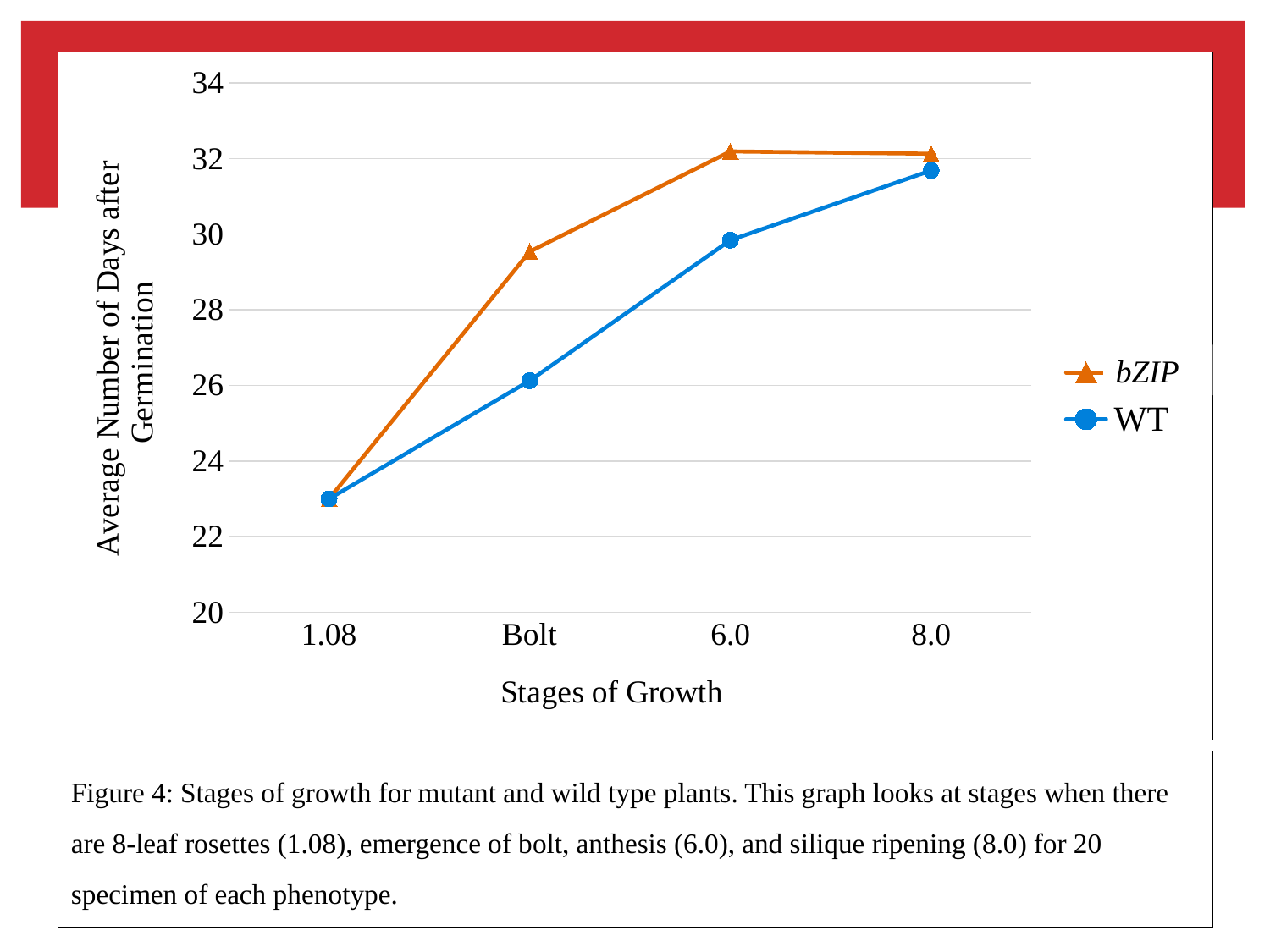
What kind of chart is shown on the slide? line chart Which series is plotted with triangle markers? bZIP Is the value for WT at Bolt greater or less than 28? less At the Bolt stage, which series has the higher value, bZIP or WT? bZIP Is the value for WT at 6.0 greater or less than 28? greater Is the value for WT at 8.0 greater or less than 30? greater What is the title of the x axis? Stages of Growth Do the WT values rise or fall from 1.08 to 8.0? rise How many stages of growth are plotted along the x axis? 4 How many series does the legend list? 2 At which stage of growth is the WT value highest? 8.0